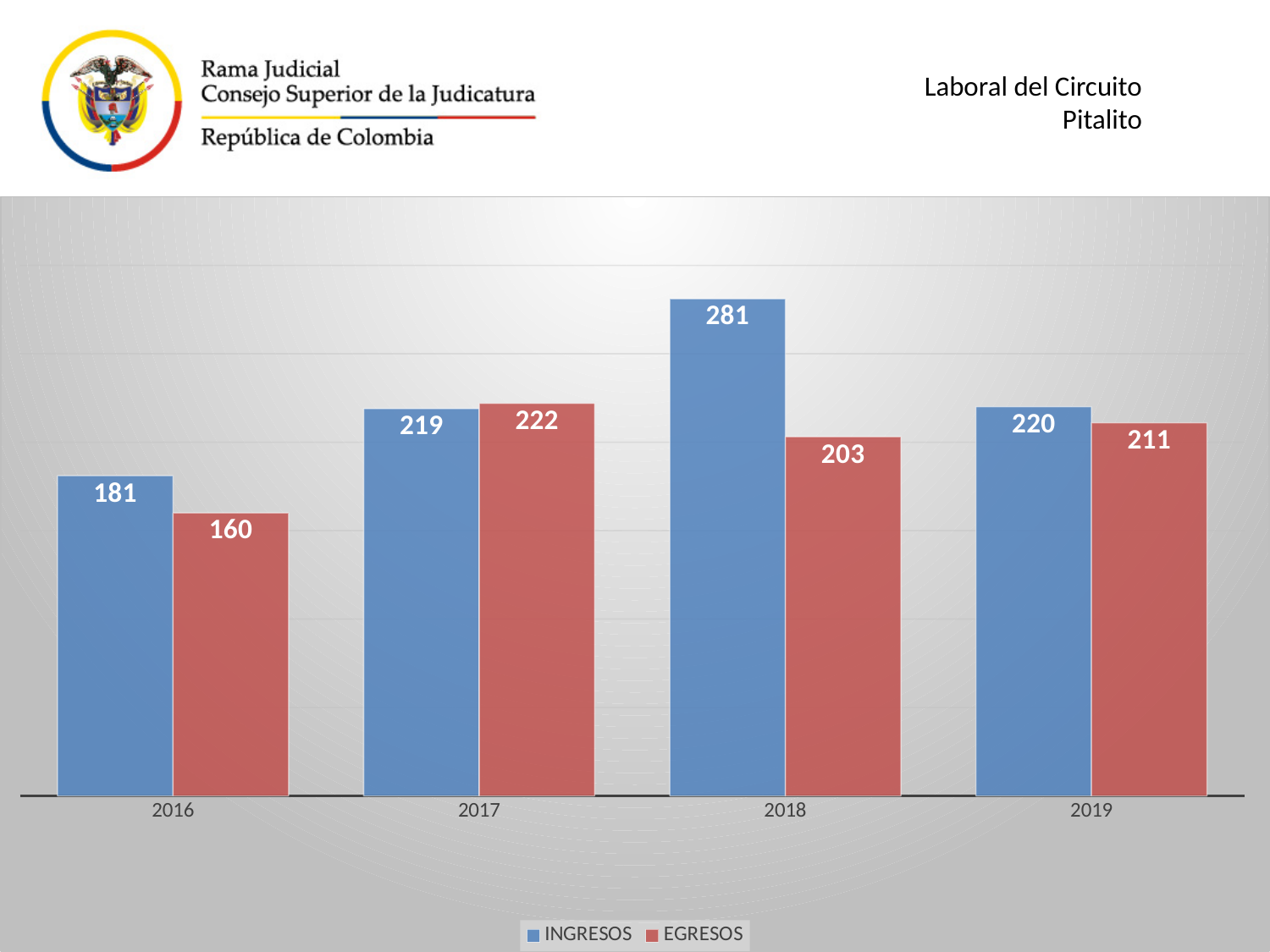
What is the difference between INGRESOS in 2016 and INGRESOS in 2017? 38 What is the difference between INGRESOS and EGRESOS in 2018? 78 What is the EGRESOS value for 2019? 211 How many series does the legend list? 2 What is the INGRESOS value for 2018? 281 Which year has the highest INGRESOS value? 2018 What is the EGRESOS value for 2016? 160 Which colour represents the EGRESOS series? Red How many years are shown on the x axis? 4 Which year has the lowest EGRESOS value? 2016 In 2017, which is larger, INGRESOS or EGRESOS? EGRESOS What kind of chart is shown on the slide? Bar chart